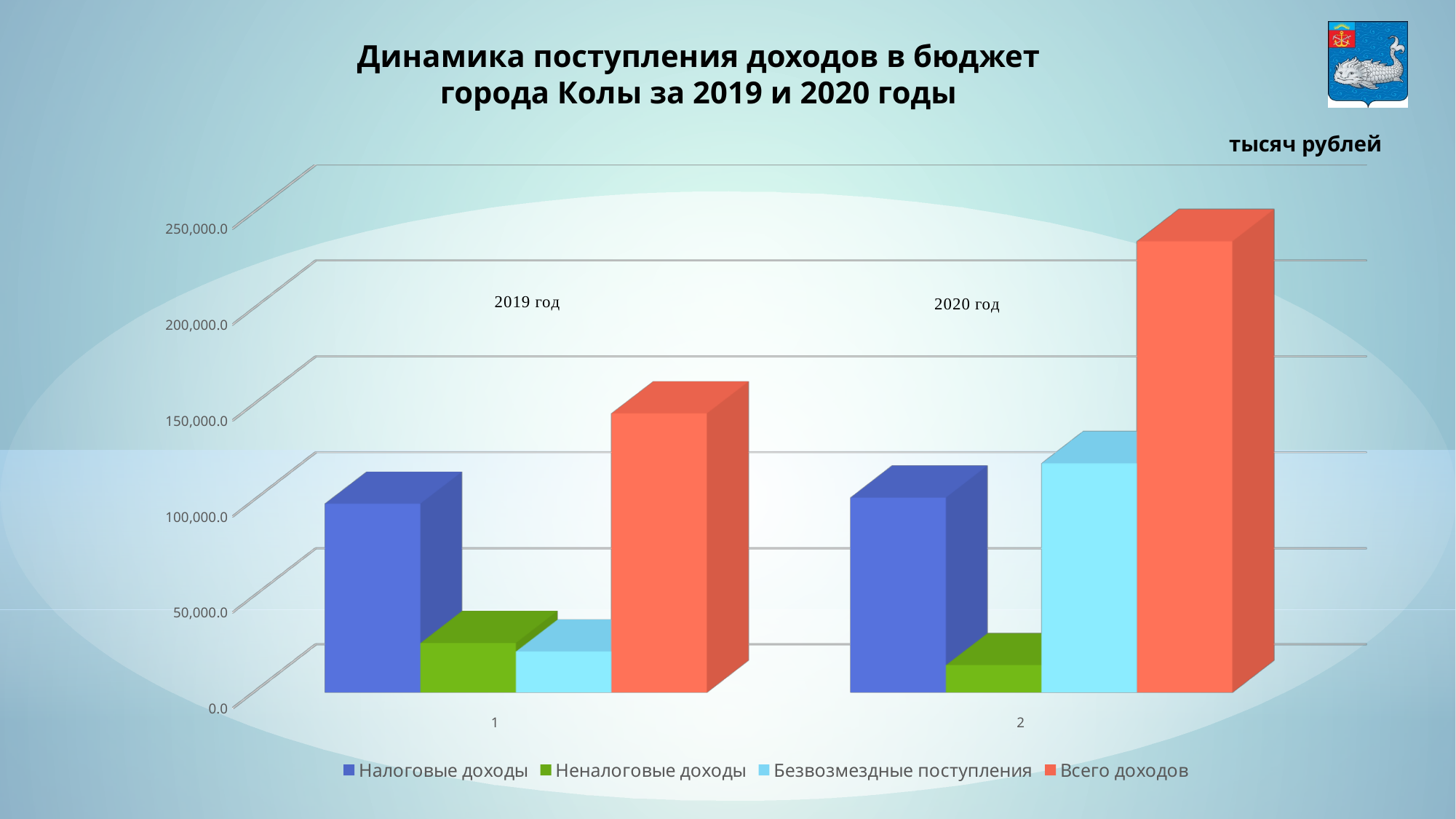
How many series does the legend list? 4 What unit of measurement is stated above the chart? тысяч рублей What kind of chart is shown on the slide? bar chart Is the value for Неналоговые доходы in 2019 год greater or less than 50,000.0? less How many year groups are plotted on the chart? 2 Is the value for Всего доходов in 2020 год greater or less than 200,000.0? greater Which series has the highest value in the 2019 год group? Всего доходов Is the value for Безвозмездные поступления in 2020 год greater or less than 100,000.0? greater Which series has the highest value in the 2020 год group? Всего доходов Which series has the lowest value in the 2020 год group? Неналоговые доходы Which is larger: Безвозмездные поступления in 2019 год or in 2020 год? 2020 год Which is larger: Всего доходов in 2019 год or Всего доходов in 2020 год? 2020 год